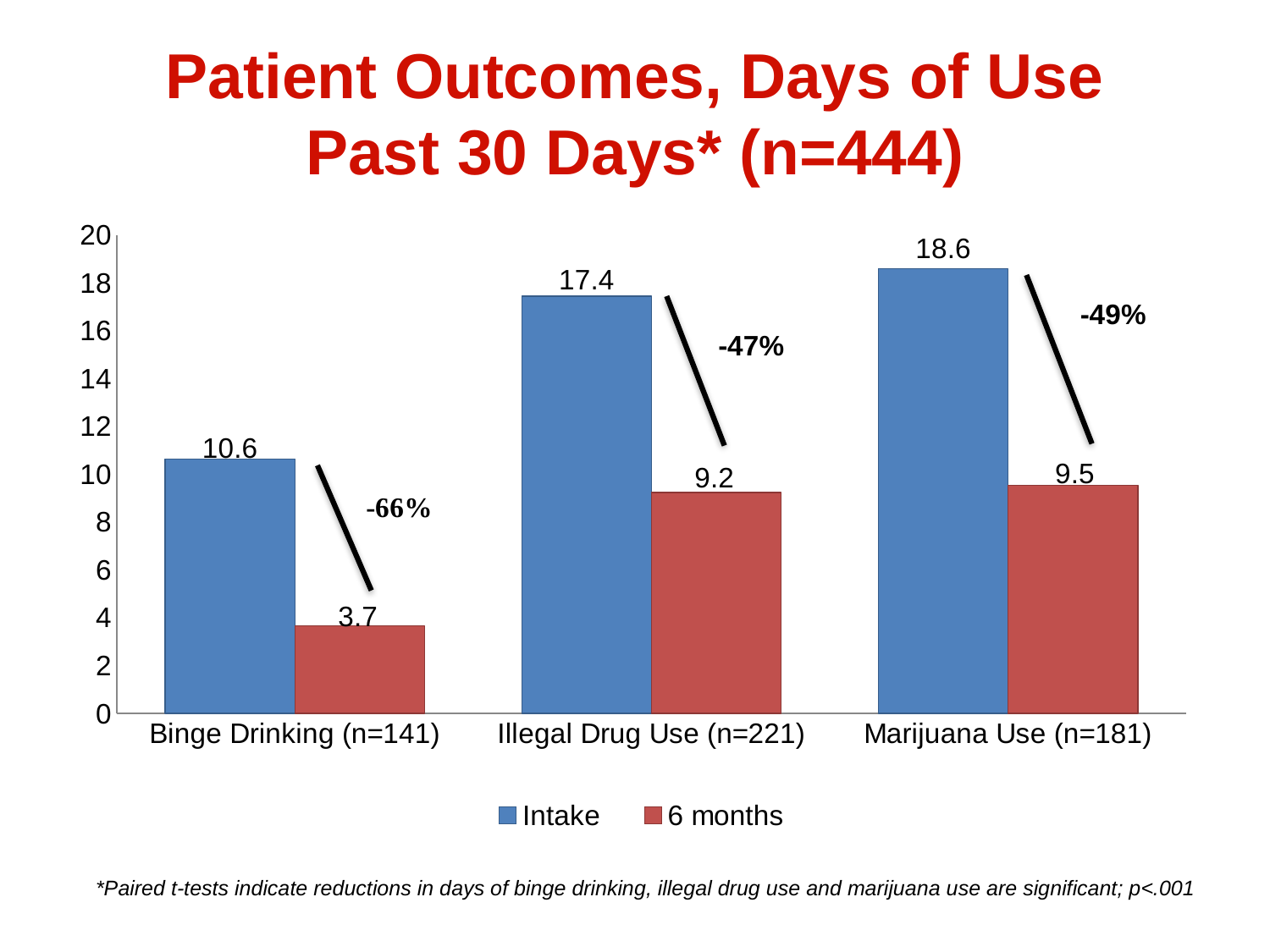
Is the Intake value for Illegal Drug Use (n=221) greater or less than 16? greater What is the difference between the Intake and 6 months values for Binge Drinking (n=141)? 6.9 Which category has the lowest 6 months value? Binge Drinking (n=141) What percentage reduction is annotated for Marijuana Use (n=181)? -49% What is the 6 months value for Illegal Drug Use (n=221)? 9.2 What kind of chart is shown on the slide? Bar chart How many series does the legend list? 2 What is the Intake value for Binge Drinking (n=141)? 10.6 Which category has the highest Intake value? Marijuana Use (n=181) Which is larger: the 6 months value for Illegal Drug Use (n=221) or the 6 months value for Binge Drinking (n=141)? Illegal Drug Use (n=221) What is the Intake value for Marijuana Use (n=181)? 18.6 How many categories are shown on the x axis? 3